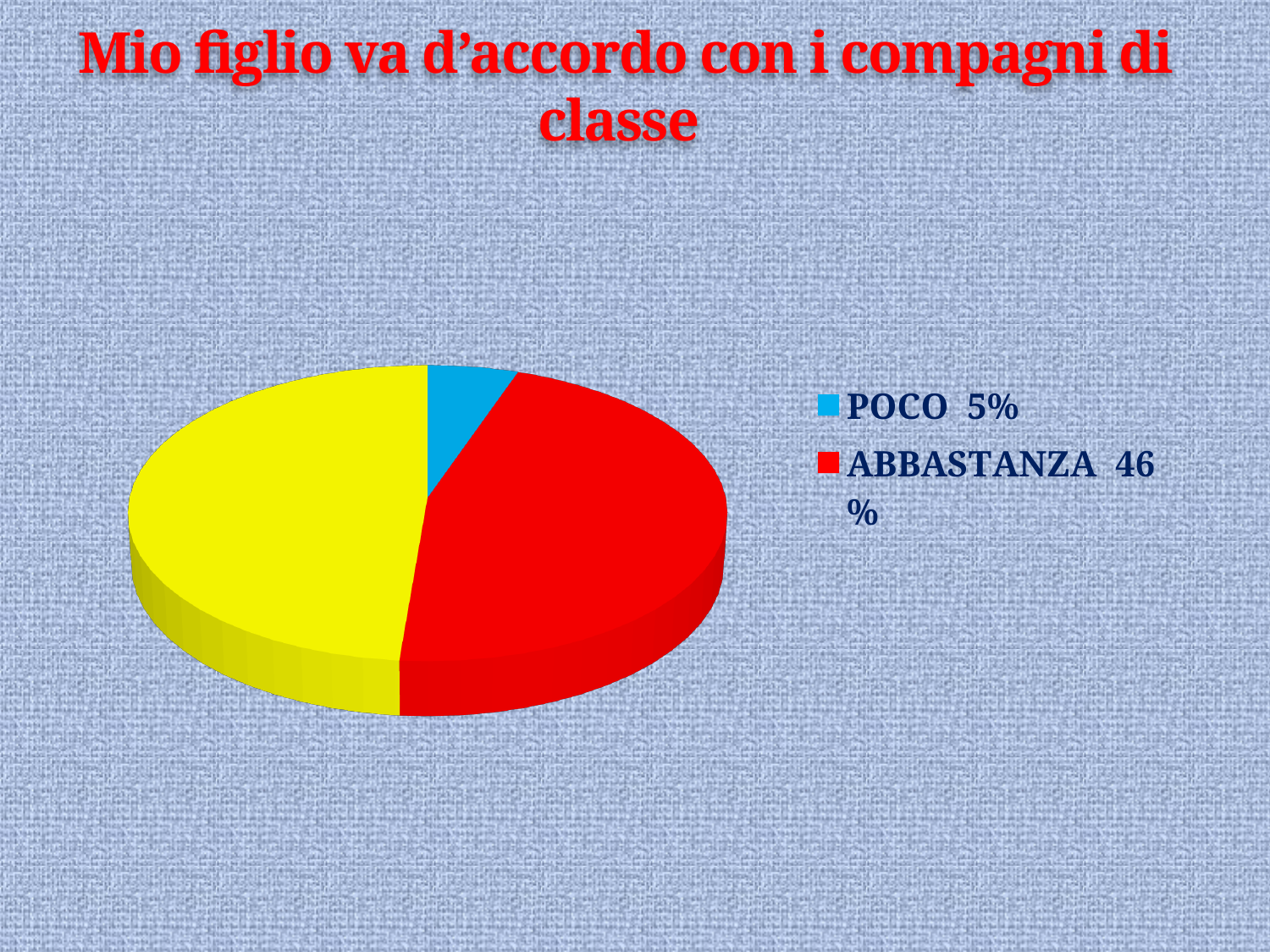
What is the title of the slide? Mio figlio va d'accordo con i compagni di classe What percentage is shown for ABBASTANZA in the pie chart? 46% Which is larger, the POCO slice or the ABBASTANZA slice? ABBASTANZA How many entries does the legend list? 2 What is the difference in percentage points between ABBASTANZA and POCO? 41 What colour is the POCO slice in the pie chart? Blue What kind of chart is shown on the slide? Pie chart What percentage is shown for POCO in the pie chart? 5% Which of the two legend entries has the smaller share of the pie? POCO How many slices does the pie chart have? 3